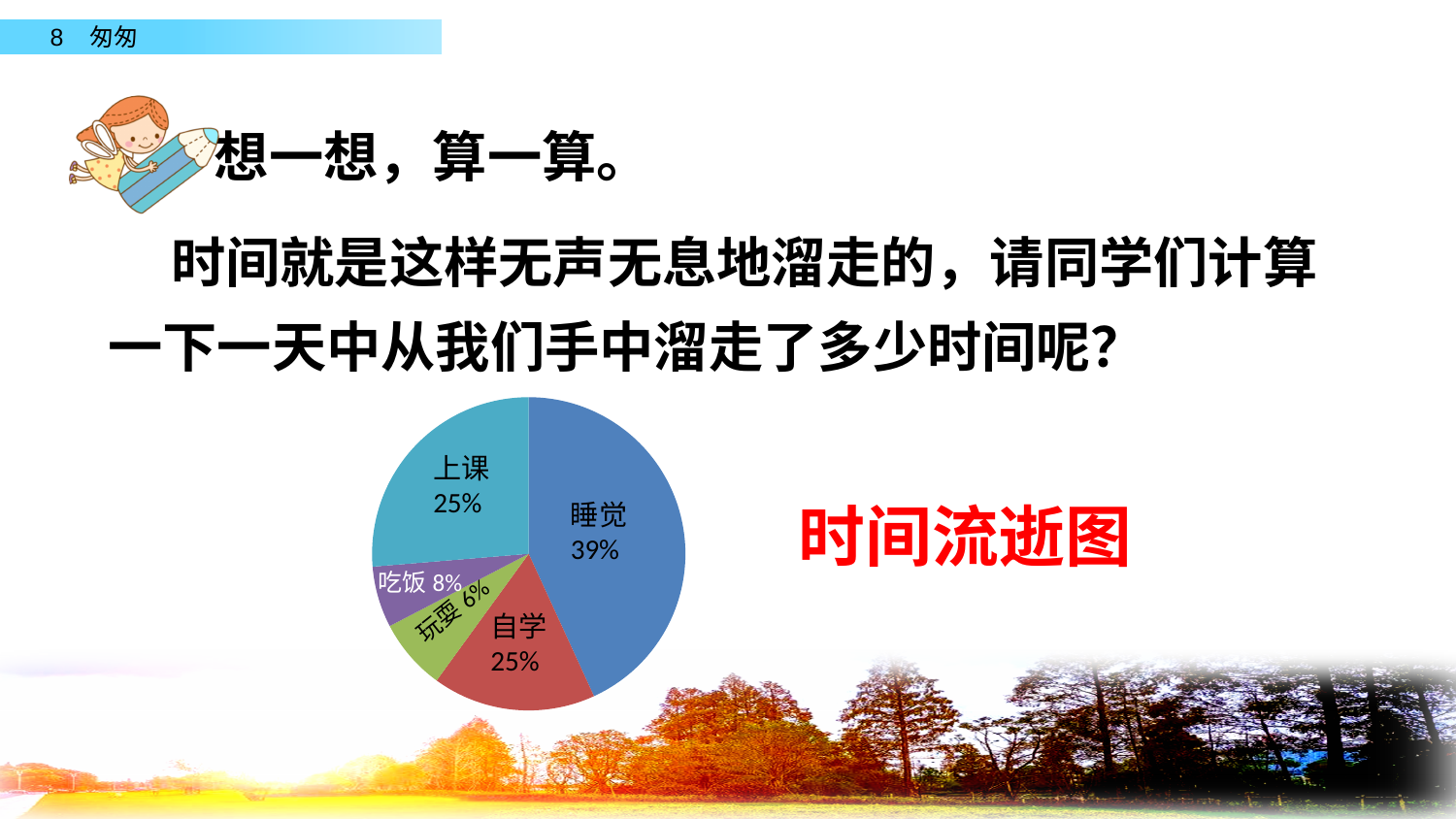
What share of the pie chart does 吃饭 take? 8% Which is larger in the pie chart, 吃饭 or 玩耍? 吃饭 What is the difference in percentage points between 吃饭 and 玩耍? 2 What percentage is shown for 玩耍 in the pie chart? 6% How many percentage points larger is 睡觉 than 自学 in the pie chart? 14 What percentage of the pie chart is 睡觉? 39% What is the title written in red next to the chart? 时间流逝图 What type of chart is shown on the slide? pie chart How many categories does the pie chart show? 5 Which category has the smallest slice in the pie chart? 玩耍 Which category has the largest slice in the pie chart? 睡觉 What percentage is shown for 上课 in the pie chart? 25%